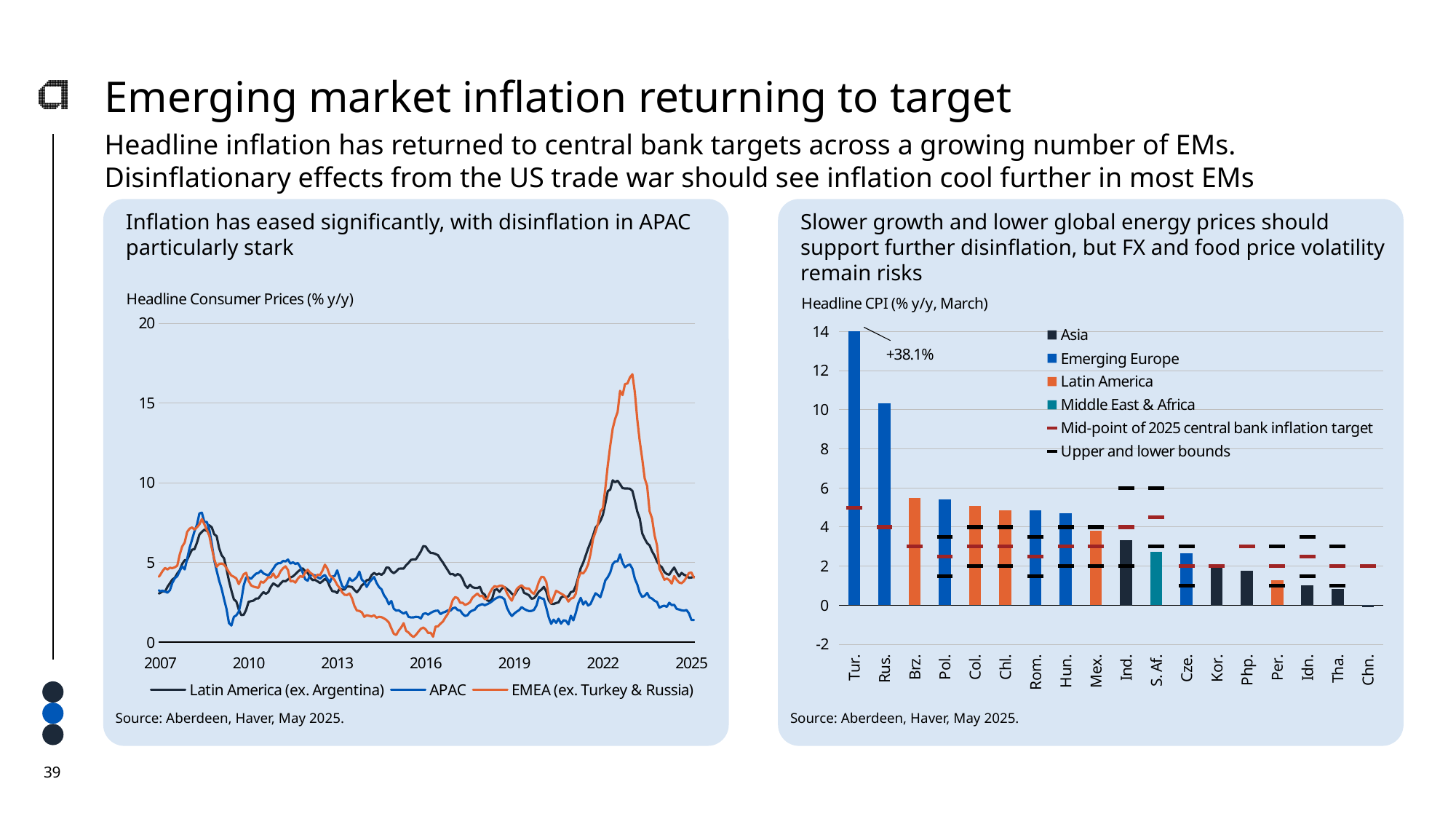
In the right chart, what value is printed next to the truncated bar for Tur.? +38.1% In the left chart, which series reaches the highest peak around 2022-2023? EMEA (ex. Turkey & Russia) In the right chart 'Headline CPI (% y/y, March)', which country has the highest value? Tur. In the right chart, which is larger, the value for Rus. or the value for Brz.? Rus. How many entries does the legend of the right chart list? 6 What kind of chart is the left chart titled 'Headline Consumer Prices (% y/y)'? line chart How many series does the legend of the left chart list? 3 In the left chart, does the EMEA (ex. Turkey & Russia) line rise or fall between 2023 and 2025? fall In the right chart, is the value for Rus. greater or less than 8? greater In the left chart, is the APAC value at 2025 greater or less than 5? less How many countries are shown on the x axis of the right chart? 18 In the right chart, which country has the lowest value? Chn.